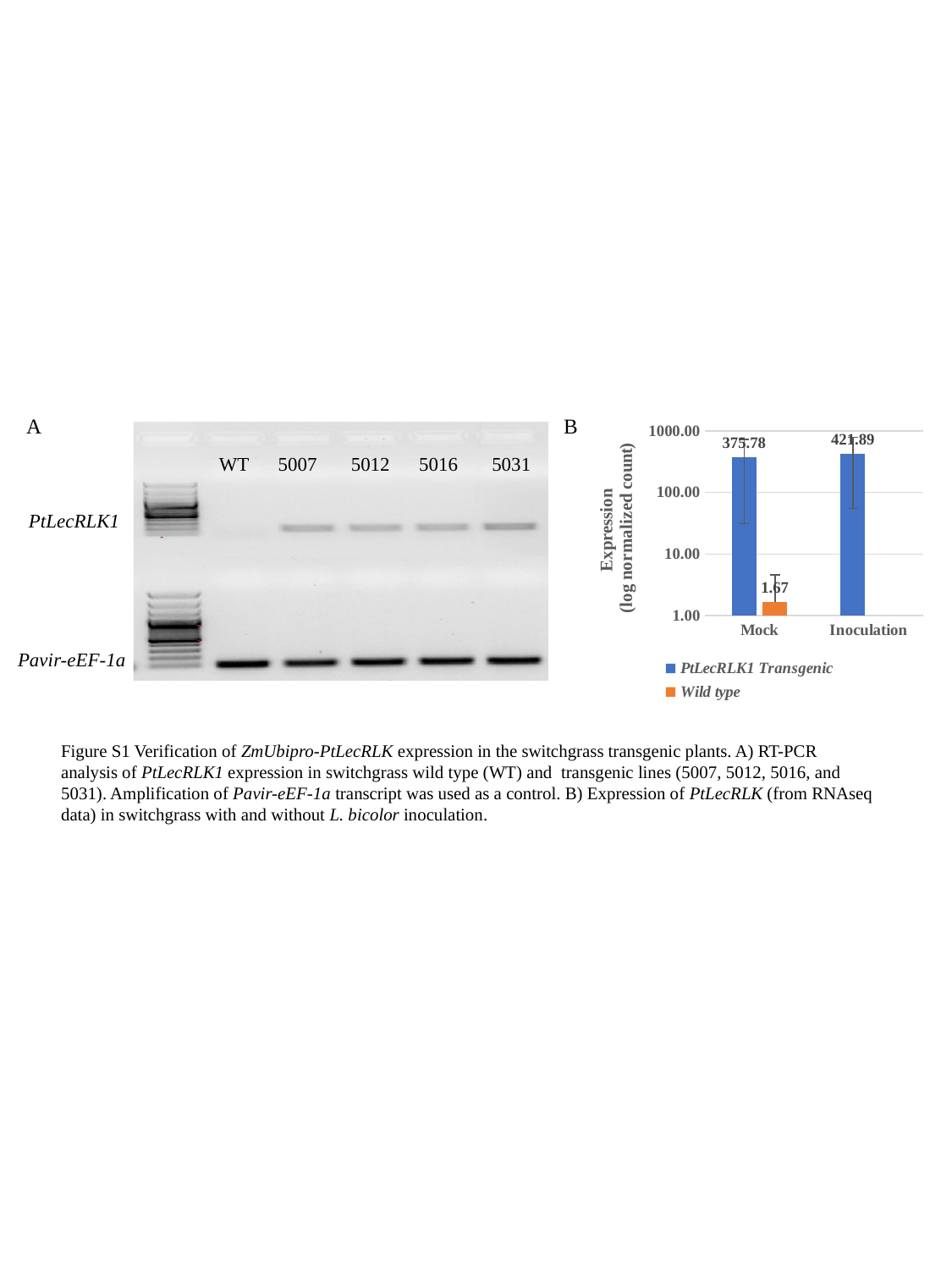
In the bar chart in panel B, which condition has the higher PtLecRLK1 Transgenic value? Inoculation In the bar chart in panel B, is the Wild type value under Mock greater or less than 10.00? less What kind of chart is shown in panel B? Bar chart How many series does the legend of the bar chart in panel B list? 2 In the bar chart in panel B, what is the value for PtLecRLK1 Transgenic under Mock? 375.78 In the bar chart in panel B, what is the value for PtLecRLK1 Transgenic under Inoculation? 421.89 In the bar chart in panel B, is the PtLecRLK1 Transgenic value under Mock greater or less than 100.00? greater In the bar chart in panel B, which is larger under Mock: PtLecRLK1 Transgenic or Wild type? PtLecRLK1 Transgenic In the bar chart in panel B, what is the value for Wild type under Mock? 1.67 How many categories are shown on the x axis of the bar chart in panel B? 2 In the bar chart in panel B, what is the difference between the PtLecRLK1 Transgenic values for Inoculation and Mock? 46.11 In the bar chart in panel B, what is the difference between the PtLecRLK1 Transgenic and Wild type values under Mock? 374.11